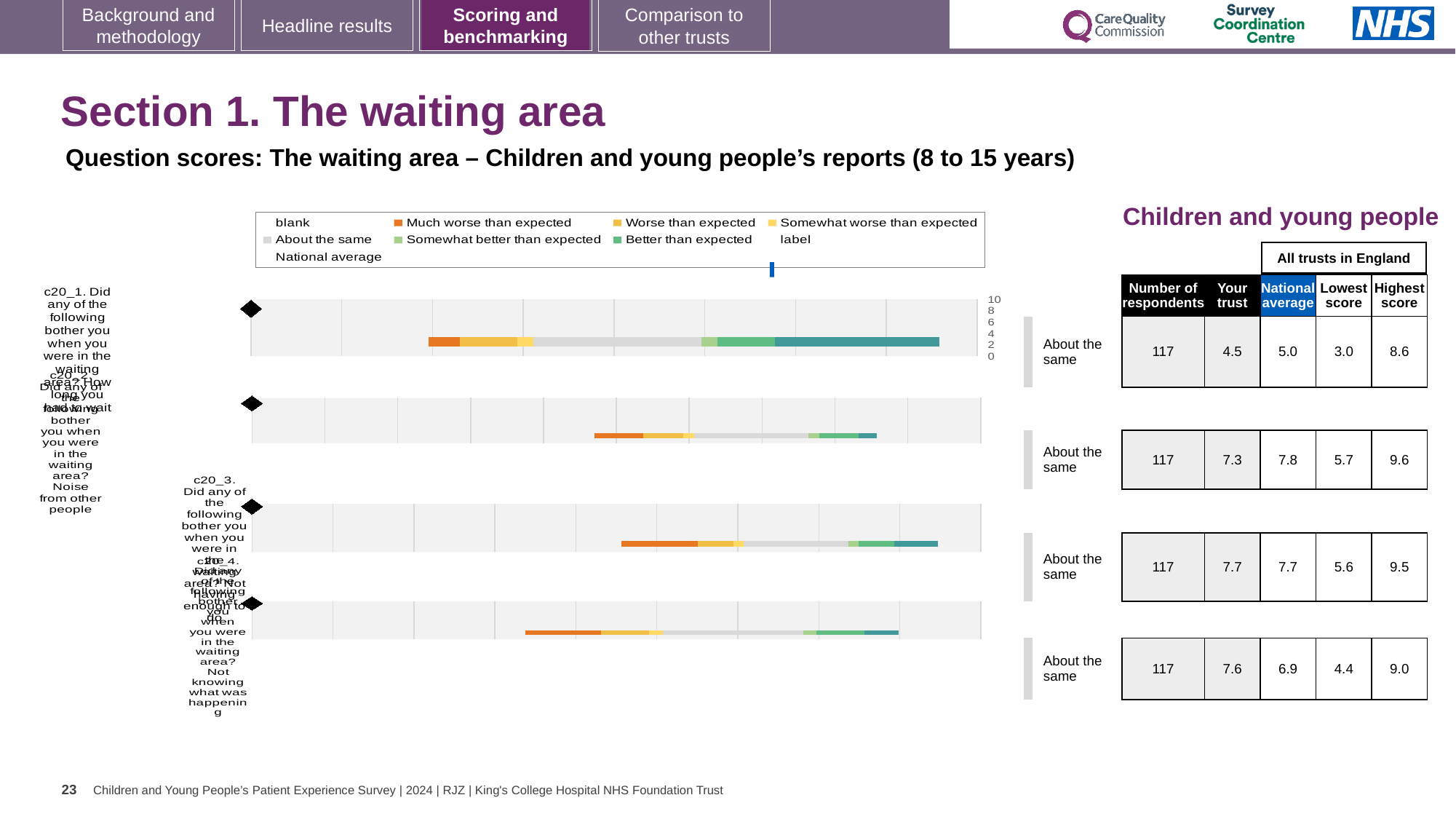
In the table beside the chart, what is the highest score for the second row? 9.6 In the table beside the chart, what is the national average for the first row (c20_1)? 5.0 How many question rows (bars) are plotted in the chart? 4 In the table beside the chart, what is the difference between the 'Your trust' score and the national average for the fourth row? 0.7 In the table beside the chart, which row has the lowest 'Your trust' score? the first row (c20_1) In the table beside the chart, what is the 'Your trust' score for the first row (c20_1)? 4.5 Which legend entry is shown in orange? Much worse than expected What benchmark category is shown next to each of the four bars? About the same In the table beside the chart, is the 'Your trust' score for the second row larger or smaller than its national average? smaller What kind of chart is shown on the slide? bar chart In the table beside the chart, what is the number of respondents for each row? 117 What is the highest value shown on the chart's numeric axis? 10